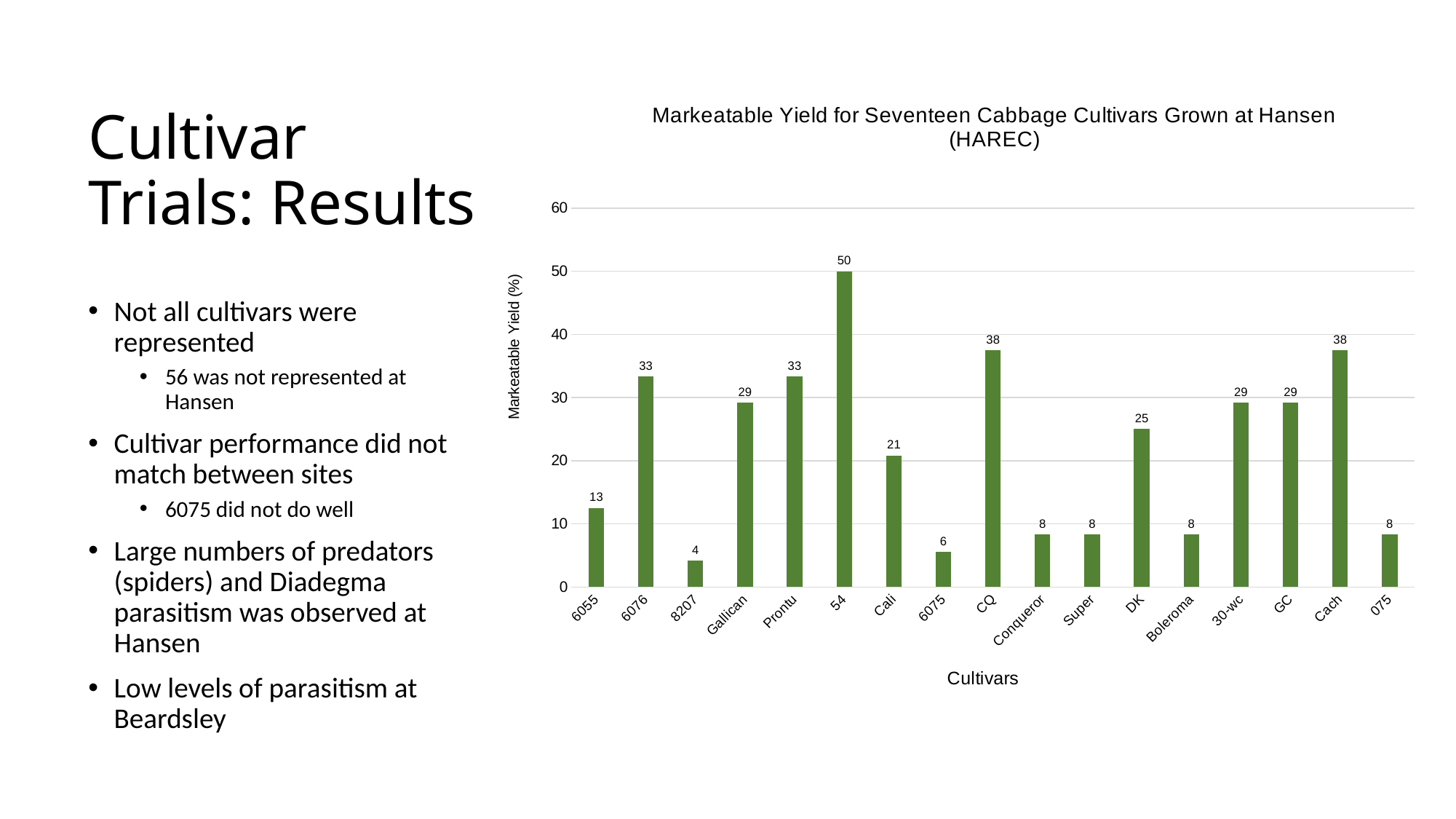
Which cultivar has the lowest marketable yield? 8207 What is the marketable yield for cultivar 54? 50 What kind of chart is shown on the slide? Bar chart What is the marketable yield for Cali? 21 What is the difference in marketable yield between 54 and CQ? 12 What is the label of the y axis of the chart? Markeatable Yield (%) Which cultivar has the highest marketable yield? 54 How many cultivars are shown on the x axis of the chart? 17 What is the marketable yield for DK? 25 Which has a higher marketable yield, 6055 or Conqueror? 6055 What is the difference in marketable yield between 6076 and 6075? 27 Which has a higher marketable yield, Gallican or Cach? Cach